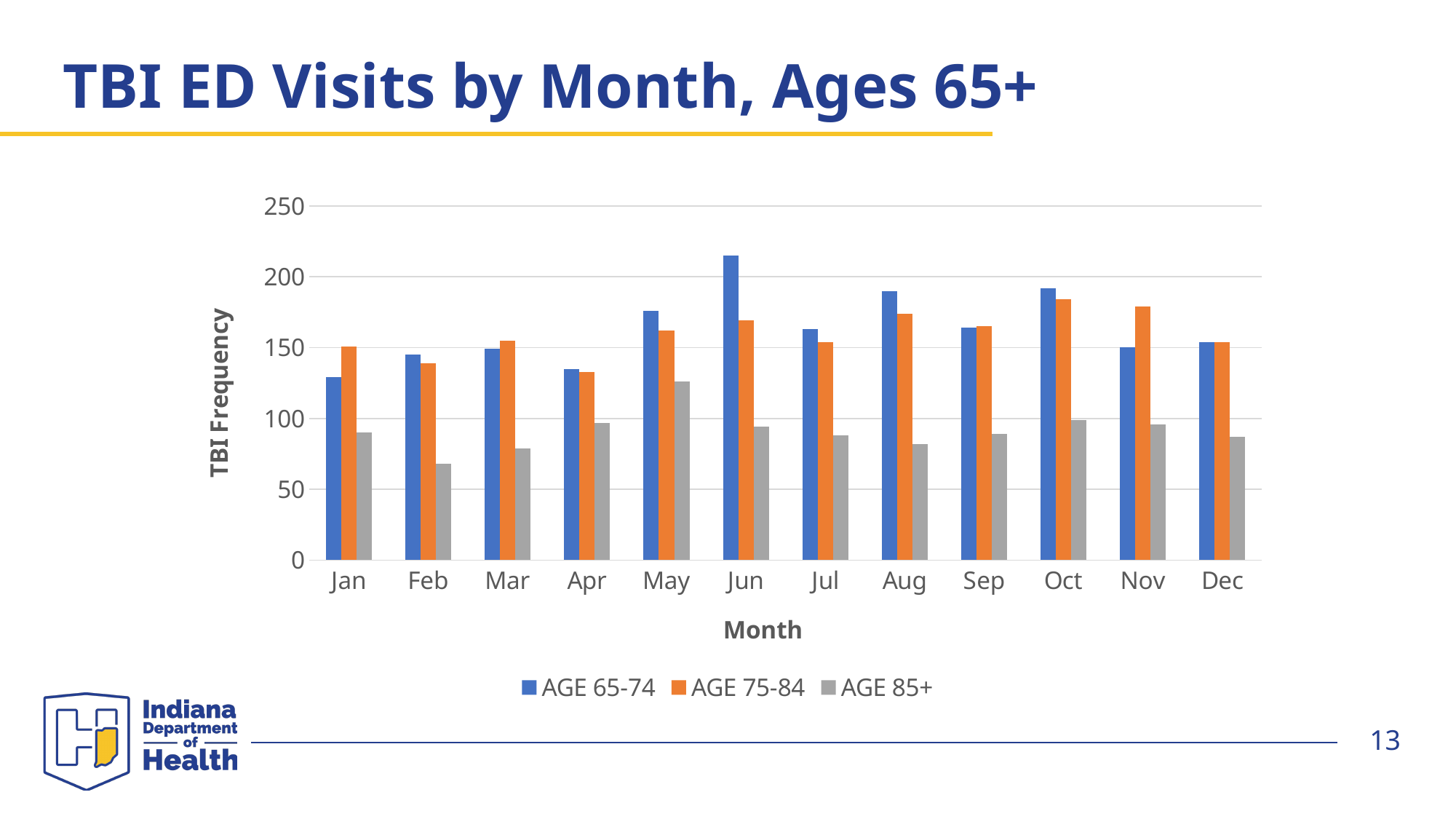
In Jun, which series has the larger value, AGE 65-74 or AGE 75-84? AGE 65-74 How many months are shown on the x axis? 12 What kind of chart is shown on the slide? Bar chart How many series does the legend list? 3 Is the AGE 65-74 value for Jun greater or less than 200? greater In which month is the AGE 85+ value highest? May In which month is the AGE 65-74 value highest? Jun Is the AGE 85+ value for Feb greater or less than 100? less Is the AGE 65-74 value for Jan greater or less than 150? less What is the title of the vertical axis? TBI Frequency In Nov, which series has the larger value, AGE 65-74 or AGE 75-84? AGE 75-84 In which month is the AGE 85+ value lowest? Feb